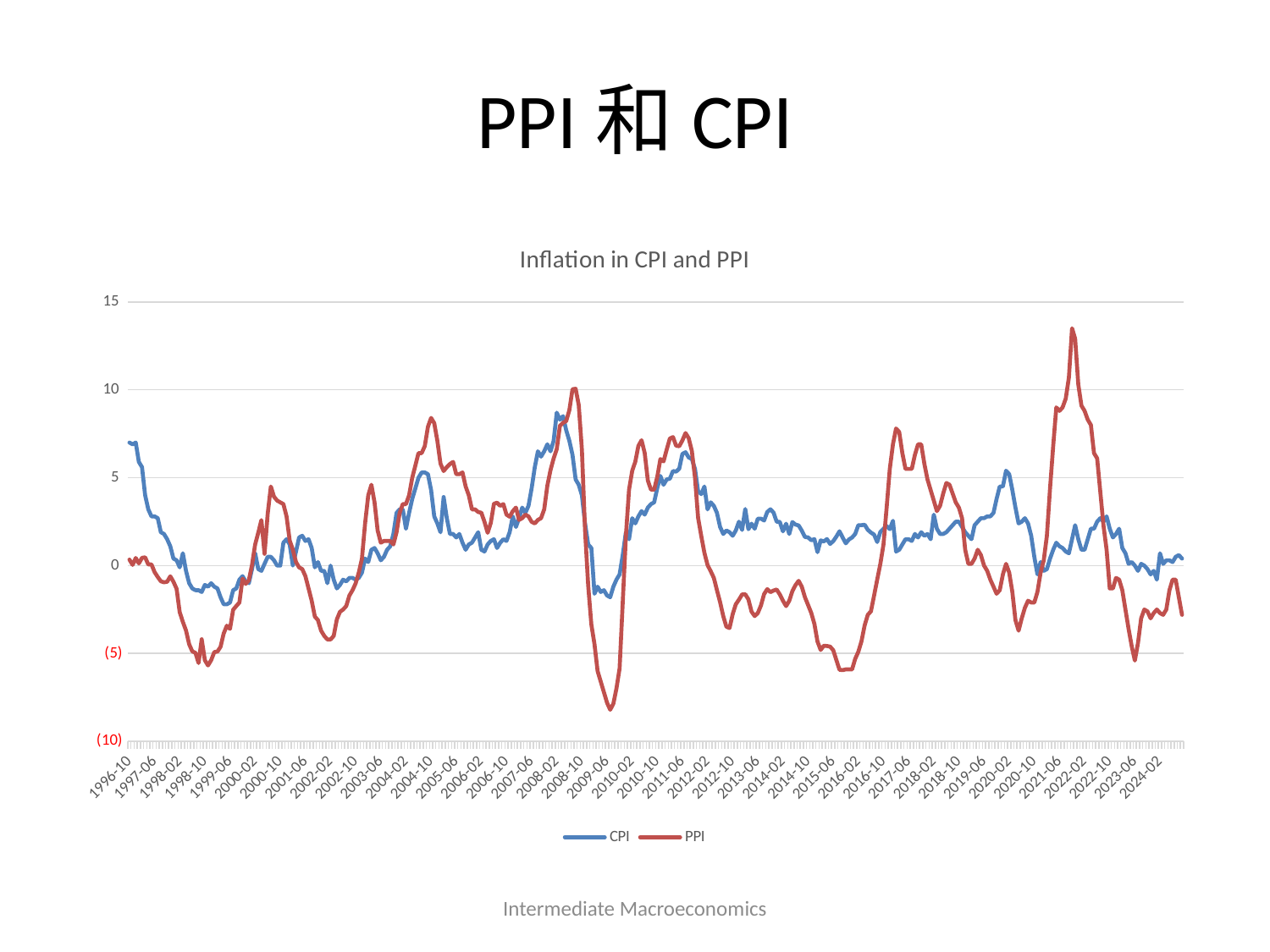
Does the PPI line rise or fall between 2021-10 and 2023-06? fall Around 2021-10, which series has the larger value, CPI or PPI? PPI Is the lowest value of the PPI line (around 2009-06) greater or less than (5)? less What kind of chart is shown on the slide? line chart What is the title of the chart? Inflation in CPI and PPI Which colour is used for the PPI line? red Which series reaches the higher peak over the whole period, CPI or PPI? PPI How many series does the legend list? 2 Which series reaches the lower trough over the whole period, CPI or PPI? PPI Is the peak of the CPI line around 2008-02 greater or less than 5? greater Is the highest value of the PPI line (around 2021-10) greater or less than 10? greater